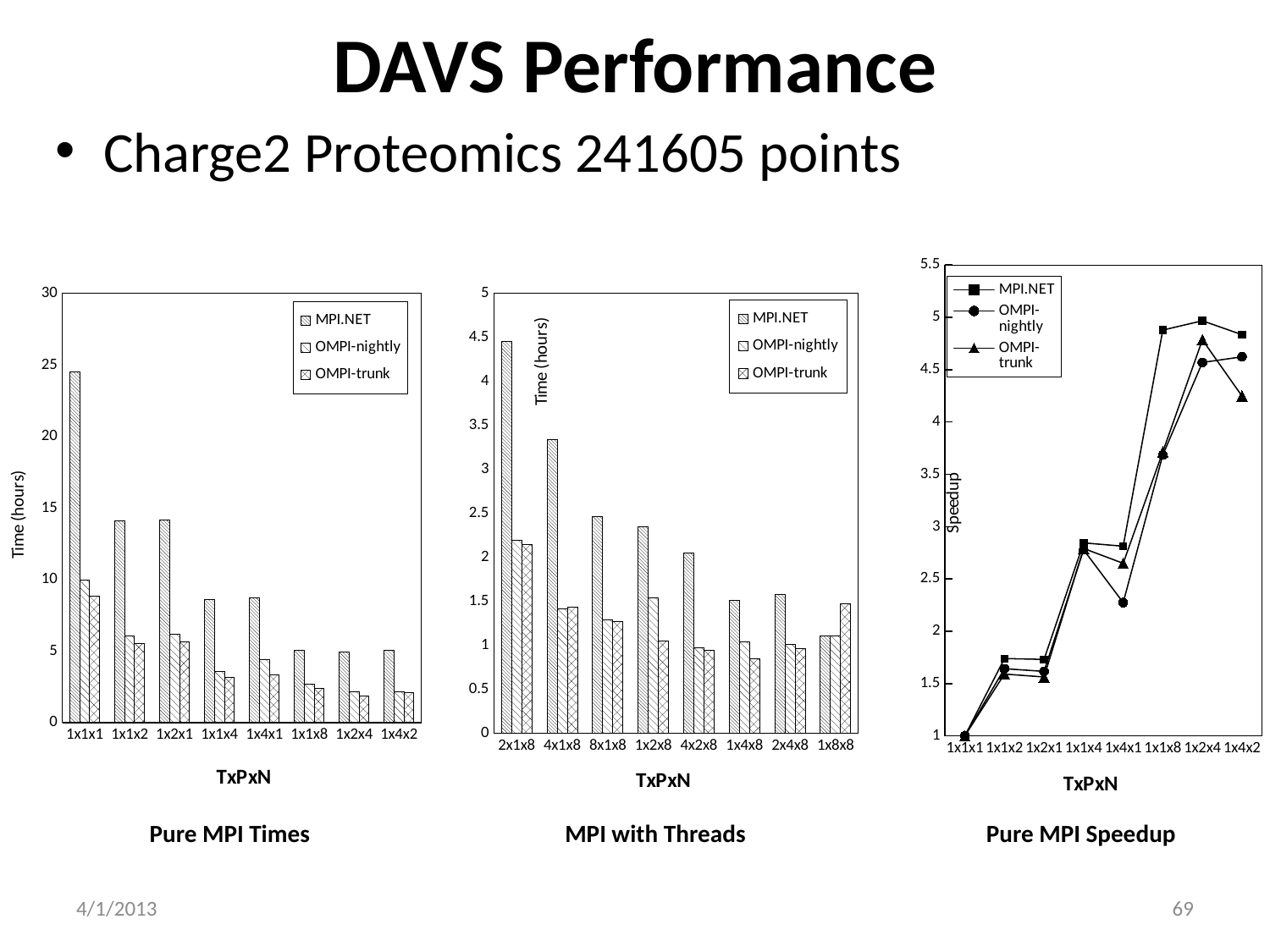
What kind of chart is the Pure MPI Times chart? bar chart How many series does the legend of the Pure MPI Times chart list? 3 What is the y-axis label of the Pure MPI Times chart? Time (hours) In the Pure MPI Times chart, is the MPI.NET value for 1x1x1 greater or less than 20? greater What kind of chart is the Pure MPI Speedup chart? line chart In the Pure MPI Speedup chart, is the MPI.NET value for 1x2x4 greater or less than 4.5? greater In the MPI with Threads chart, is the MPI.NET value for 2x1x8 greater or less than 4? greater How many TxPxN categories are shown on the x axis of the MPI with Threads chart? 8 In the MPI with Threads chart, which TxPxN category has the lowest MPI.NET time? 1x8x8 In the Pure MPI Speedup chart, does the MPI.NET speedup generally rise or fall from 1x1x1 to 1x2x4? rise In the Pure MPI Times chart, which TxPxN category has the highest MPI.NET time? 1x1x1 In the Pure MPI Speedup chart, which is larger at 1x4x1: MPI.NET or OMPI-nightly? MPI.NET